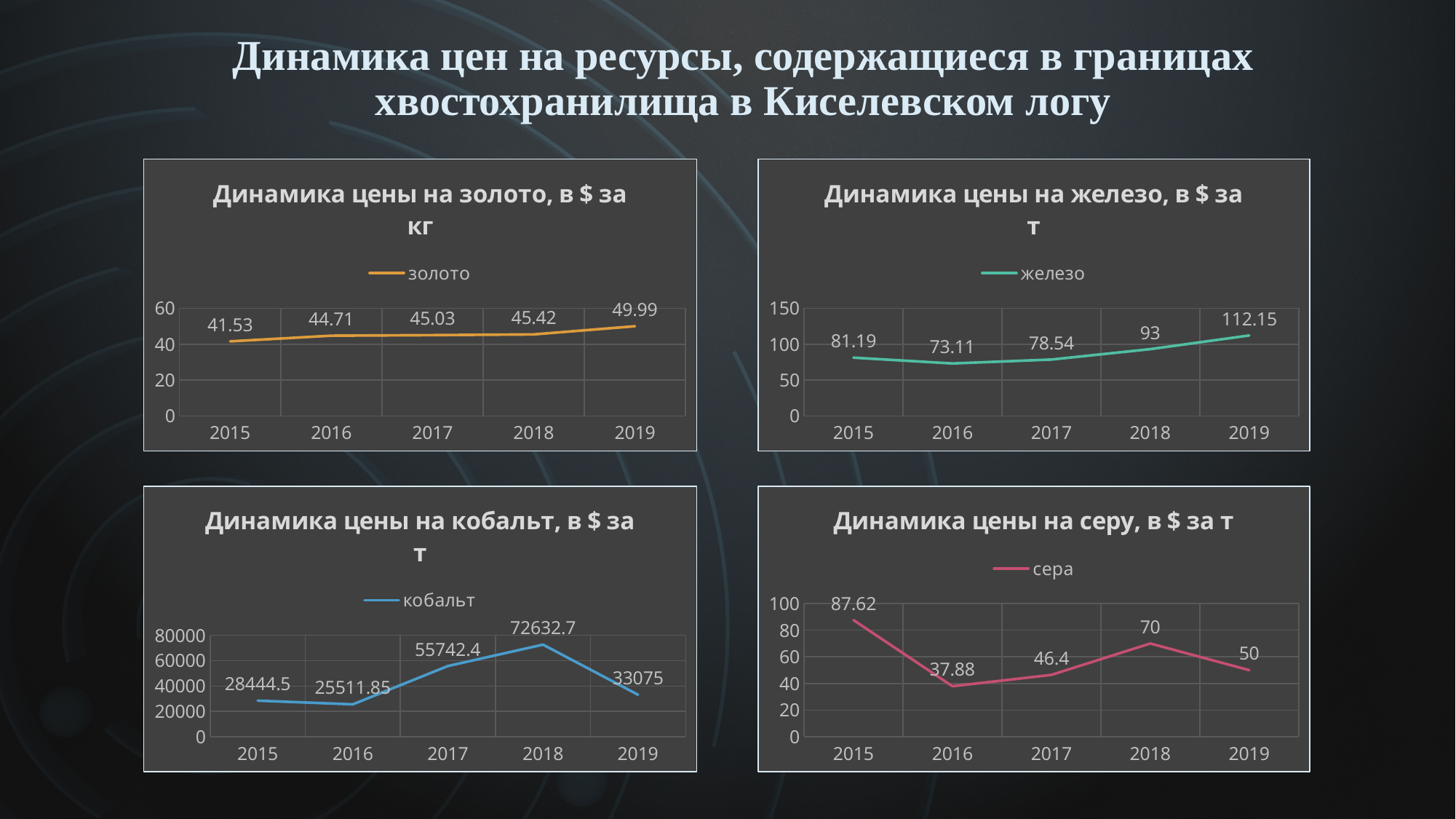
In the chart 'Динамика цены на кобальт, в $ за т', is the value for 2018 greater or less than 60000? greater In the chart 'Динамика цены на железо, в $ за т', what is the difference between the 2019 value and the 2018 value? 19.15 What is the legend entry in the chart 'Динамика цены на железо, в $ за т'? железо What kind of chart is 'Динамика цены на серу, в $ за т'? line chart How many years are plotted in the chart 'Динамика цены на золото, в $ за кг'? 5 In the chart 'Динамика цены на серу, в $ за т', which year has the lowest value? 2016 In the chart 'Динамика цены на железо, в $ за т', what is the value for 2016? 73.11 In the chart 'Динамика цены на золото, в $ за кг', do the values rise or fall from 2015 to 2019? rise In the chart 'Динамика цены на кобальт, в $ за т', which year has the highest value? 2018 In the chart 'Динамика цены на серу, в $ за т', which is larger, the value for 2015 or the value for 2018? 2015 How many series does the legend of the chart 'Динамика цены на кобальт, в $ за т' list? 1 In the chart 'Динамика цены на золото, в $ за кг', what is the value for 2019? 49.99